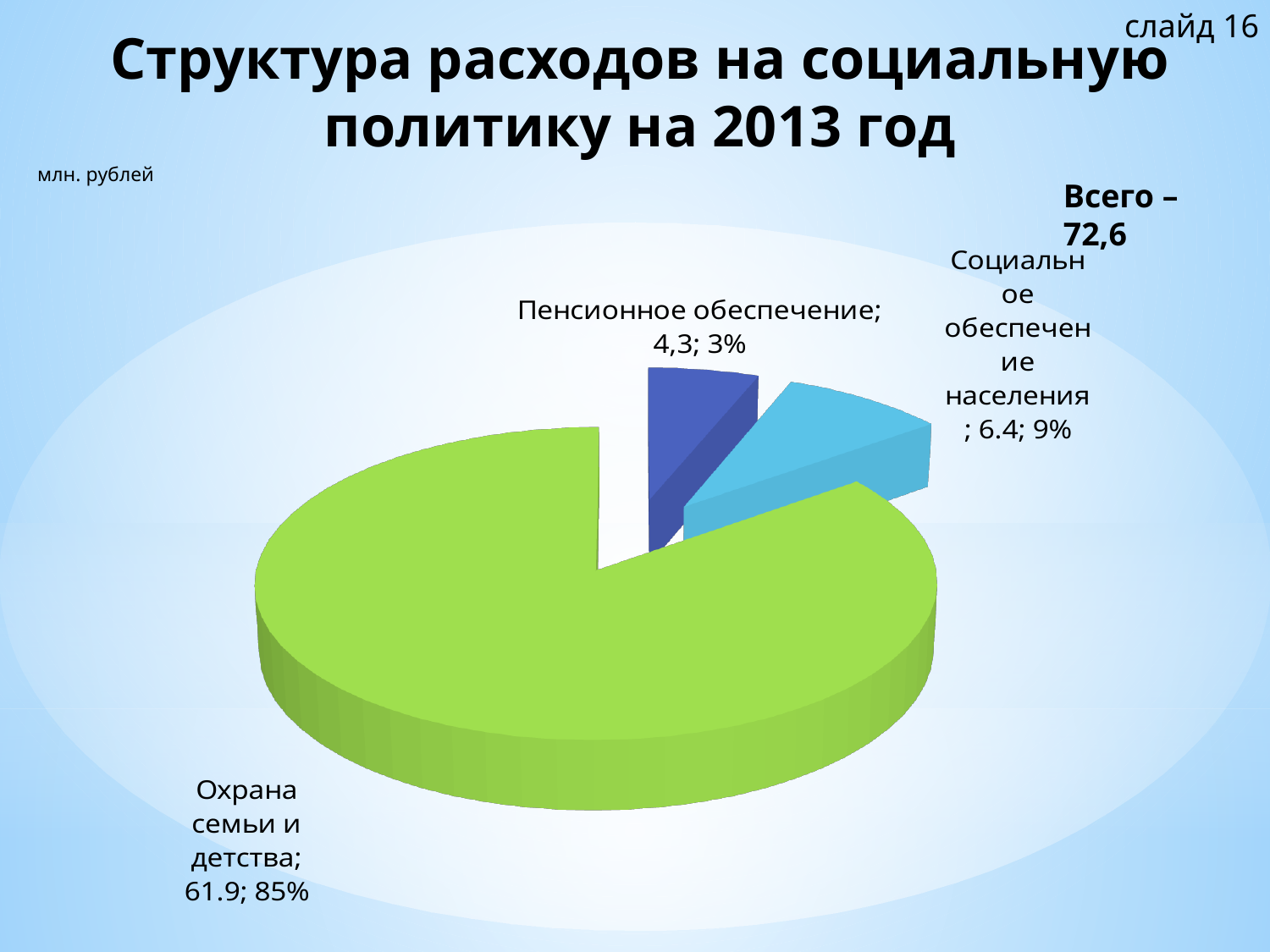
What percentage share of the pie is labelled for Пенсионное обеспечение? 3% What value is shown for Охрана семьи и детства? 61.9 How many slices does the pie chart have? 3 What total (Всего) is stated on the slide for the chart? 72,6 Which is larger, the value for Социальное обеспечение населения or the value for Пенсионное обеспечение? Социальное обеспечение населения What percentage share of the pie is labelled for Социальное обеспечение населения? 9% Which category has the largest slice of the pie? Охрана семьи и детства Which category has the smallest slice of the pie? Пенсионное обеспечение What value is shown for Социальное обеспечение населения? 6.4 What value is shown for Пенсионное обеспечение? 4,3 What percentage share of the pie is labelled for Охрана семьи и детства? 85% What kind of chart is shown on the slide? pie chart